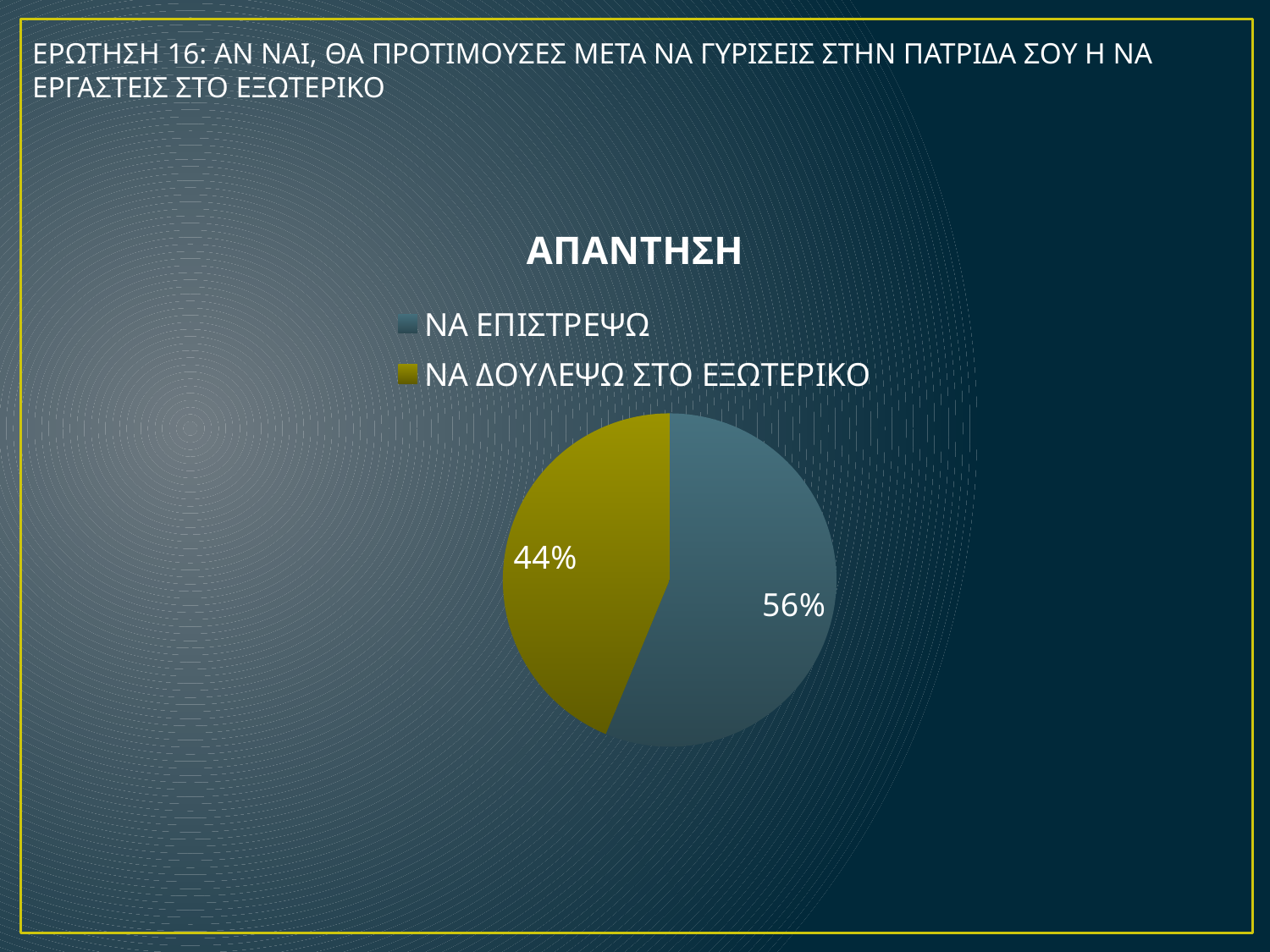
Which category has the smallest slice of the pie? ΝΑ ΔΟΥΛΕΨΩ ΣΤΟ ΕΞΩΤΕΡΙΚΟ What is the difference in percentage points between the ΝΑ ΕΠΙΣΤΡΕΨΩ slice and the ΝΑ ΔΟΥΛΕΨΩ ΣΤΟ ΕΞΩΤΕΡΙΚΟ slice? 12% Which category has the largest slice of the pie? ΝΑ ΕΠΙΣΤΡΕΨΩ What share of the pie does the ΝΑ ΕΠΙΣΤΡΕΨΩ slice represent? 56% Which is larger, the slice for ΝΑ ΕΠΙΣΤΡΕΨΩ or the slice for ΝΑ ΔΟΥΛΕΨΩ ΣΤΟ ΕΞΩΤΕΡΙΚΟ? ΝΑ ΕΠΙΣΤΡΕΨΩ What is the title of the chart? ΑΠΑΝΤΗΣΗ What percentage of the pie is labelled for ΝΑ ΔΟΥΛΕΨΩ ΣΤΟ ΕΞΩΤΕΡΙΚΟ? 44% What type of chart is shown on the slide? pie chart What percentage of the pie is labelled for ΝΑ ΕΠΙΣΤΡΕΨΩ? 56% What colour is the slice for ΝΑ ΔΟΥΛΕΨΩ ΣΤΟ ΕΞΩΤΕΡΙΚΟ? yellow How many slices does the pie chart have? 2 How many entries does the legend list? 2